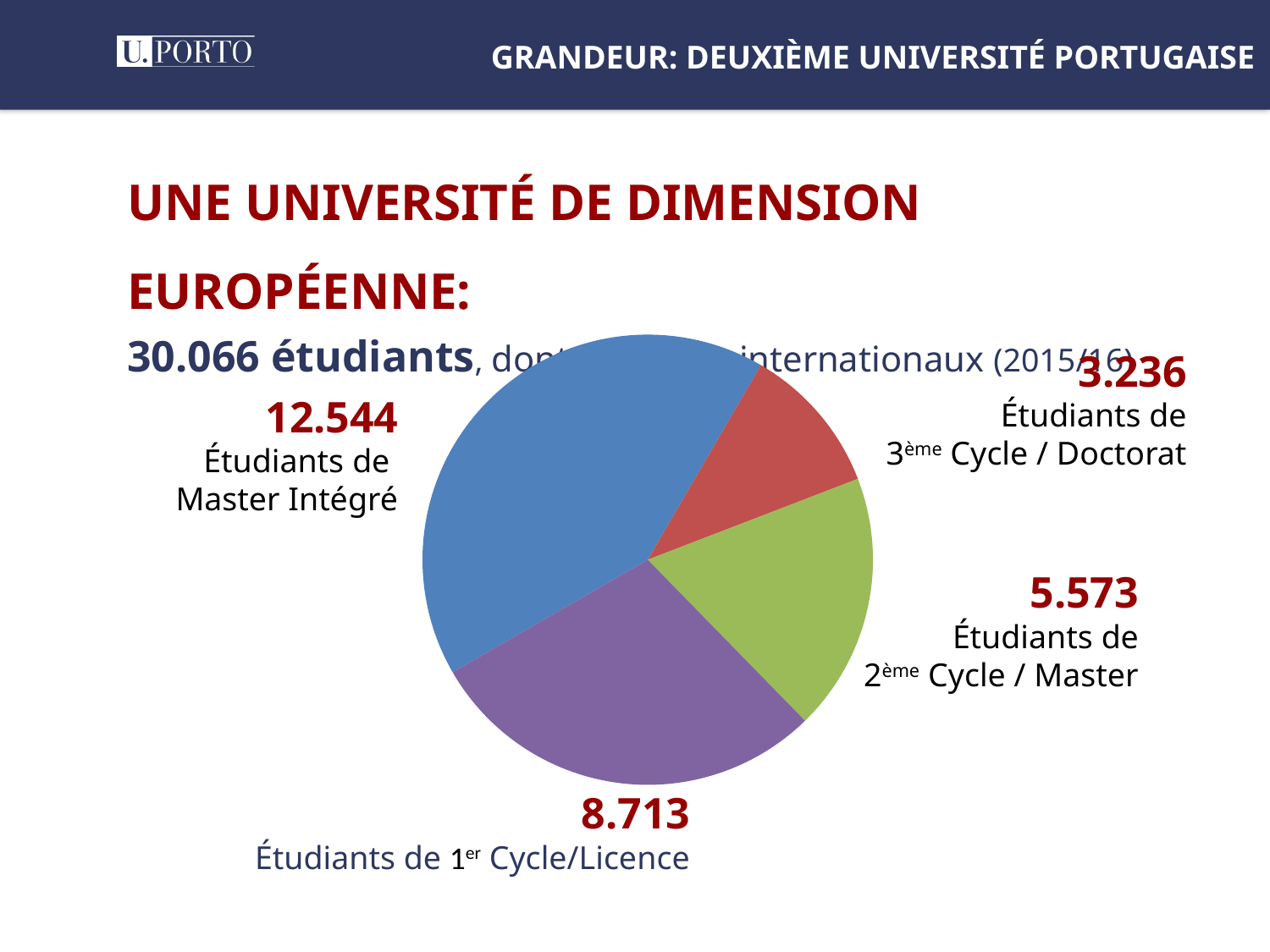
What colour is the slice representing Étudiants de Master Intégré? blue How many slices does the pie chart have? 4 What is the difference between the number of Master Intégré students and 1er Cycle/Licence students? 3.831 Which category has the largest slice of the pie chart? Étudiants de Master Intégré Which is larger: the 2ème Cycle / Master slice or the 1er Cycle/Licence slice? 1er Cycle/Licence What value is shown for Étudiants de 2ème Cycle / Master? 5.573 What type of chart is shown on the slide? pie chart How many students are in Master Intégré according to the pie chart? 12.544 What is the total number of students across all four slices of the pie chart? 30.066 Which category has the smallest slice of the pie chart? Étudiants de 3ème Cycle / Doctorat How many students are in the 1er Cycle/Licence slice? 8.713 What is the number of students in the 3ème Cycle / Doctorat slice? 3.236